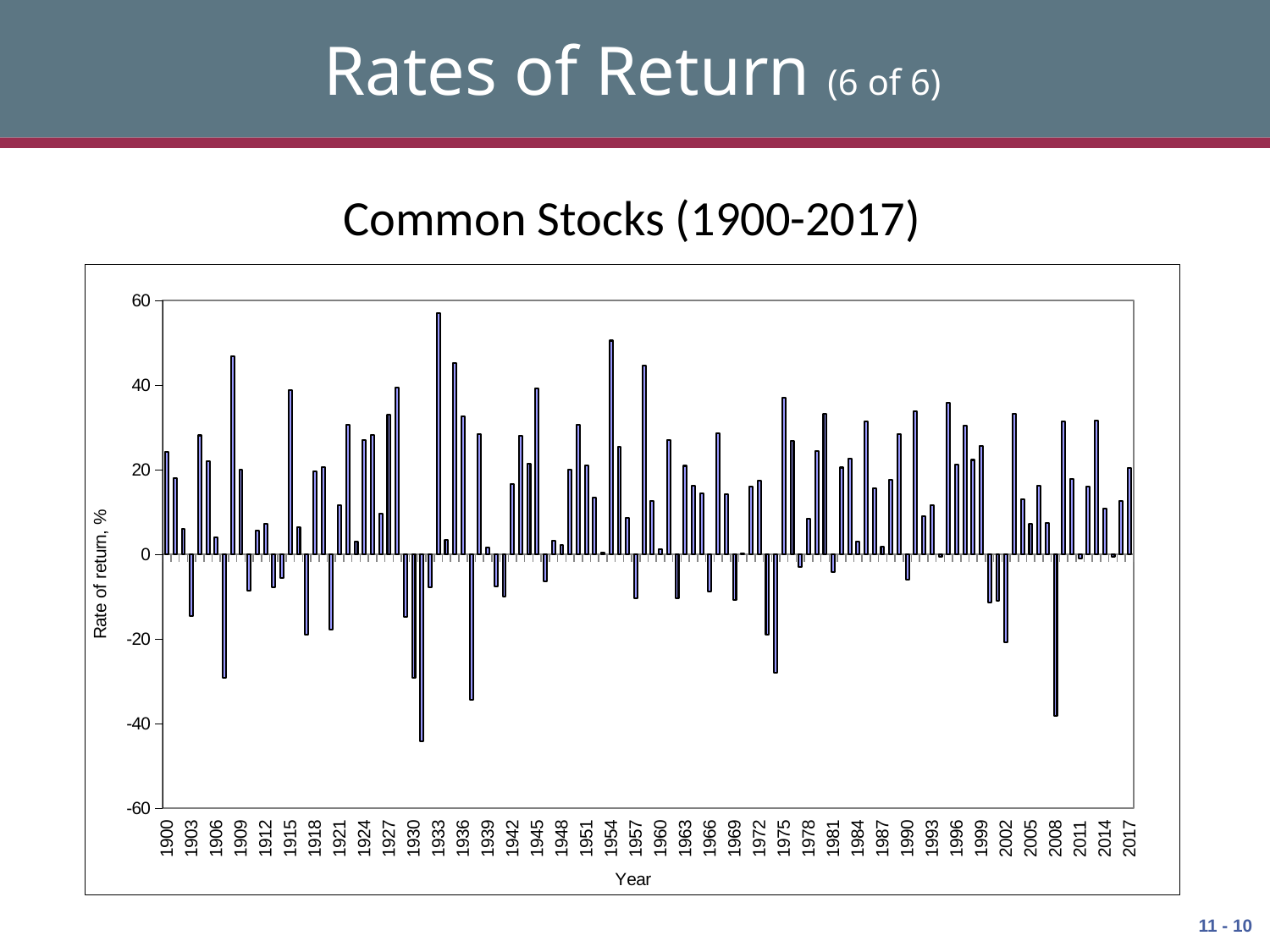
Which year has the larger rate of return, 1909 or 1930? 1909 Which labeled year has the highest rate of return in the chart? 1933 What kind of chart is shown on the slide? bar chart Is the rate of return for 2008 greater or less than -20? less Is the rate of return for 1975 greater or less than 20? greater What is the title of the chart? Common Stocks (1900-2017) What is the label on the vertical axis of the chart? Rate of return, % Is the rate of return for 1930 greater or less than -20? less Which year has the larger rate of return, 1933 or 2008? 1933